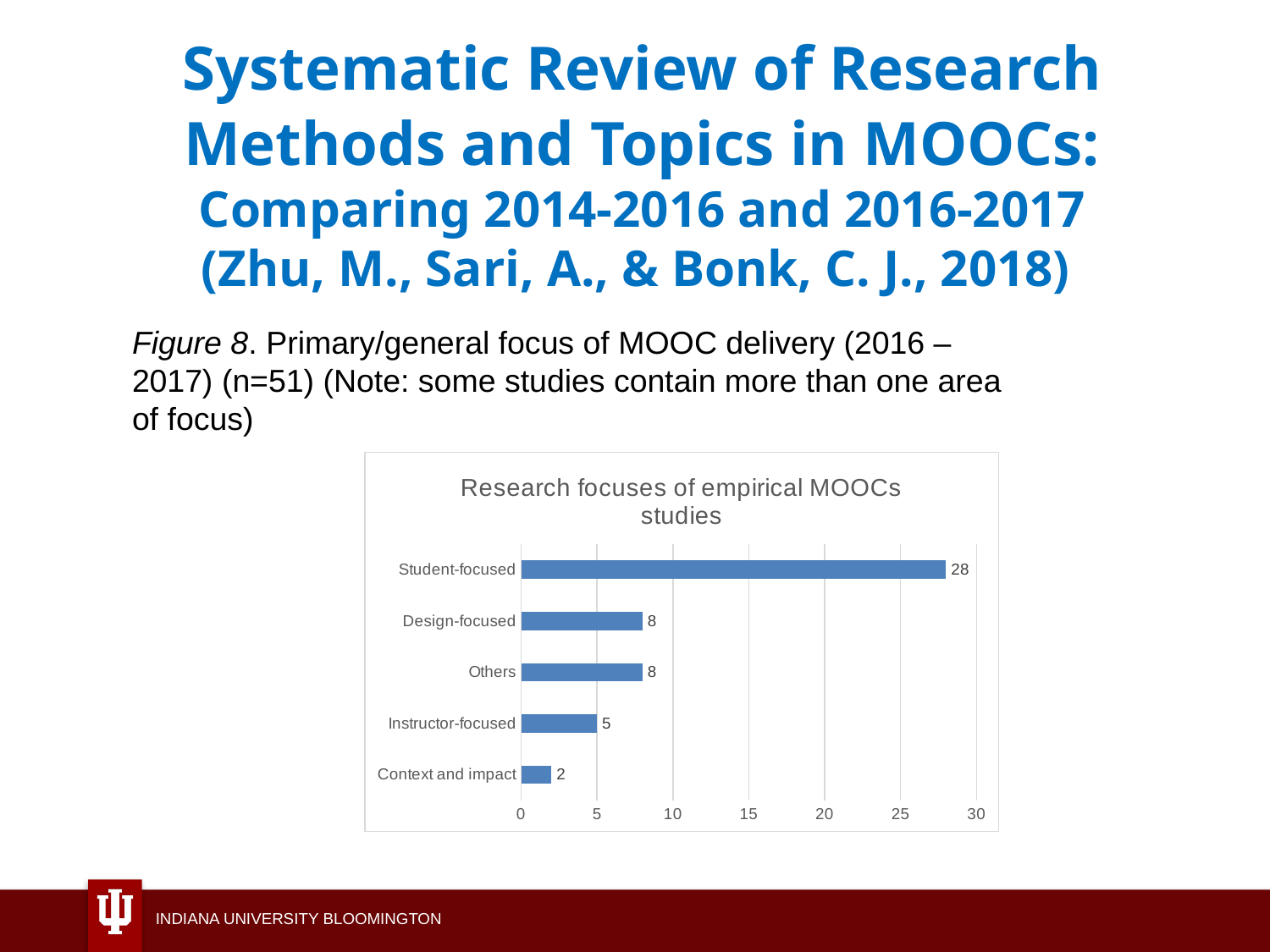
What is the title of the chart? Research focuses of empirical MOOCs studies What is the value for Student-focused? 28 How many categories are shown in the chart? 5 What is the difference between the values for Student-focused and Design-focused? 20 What is the difference between the values for Instructor-focused and Context and impact? 3 Is the value for Student-focused greater or less than 25? greater What is the value for Context and impact? 2 Which category has the highest value? Student-focused What kind of chart is shown on the slide? bar chart Which is larger, the value for Others or the value for Instructor-focused? Others Which category has the lowest value? Context and impact What is the value for Instructor-focused? 5